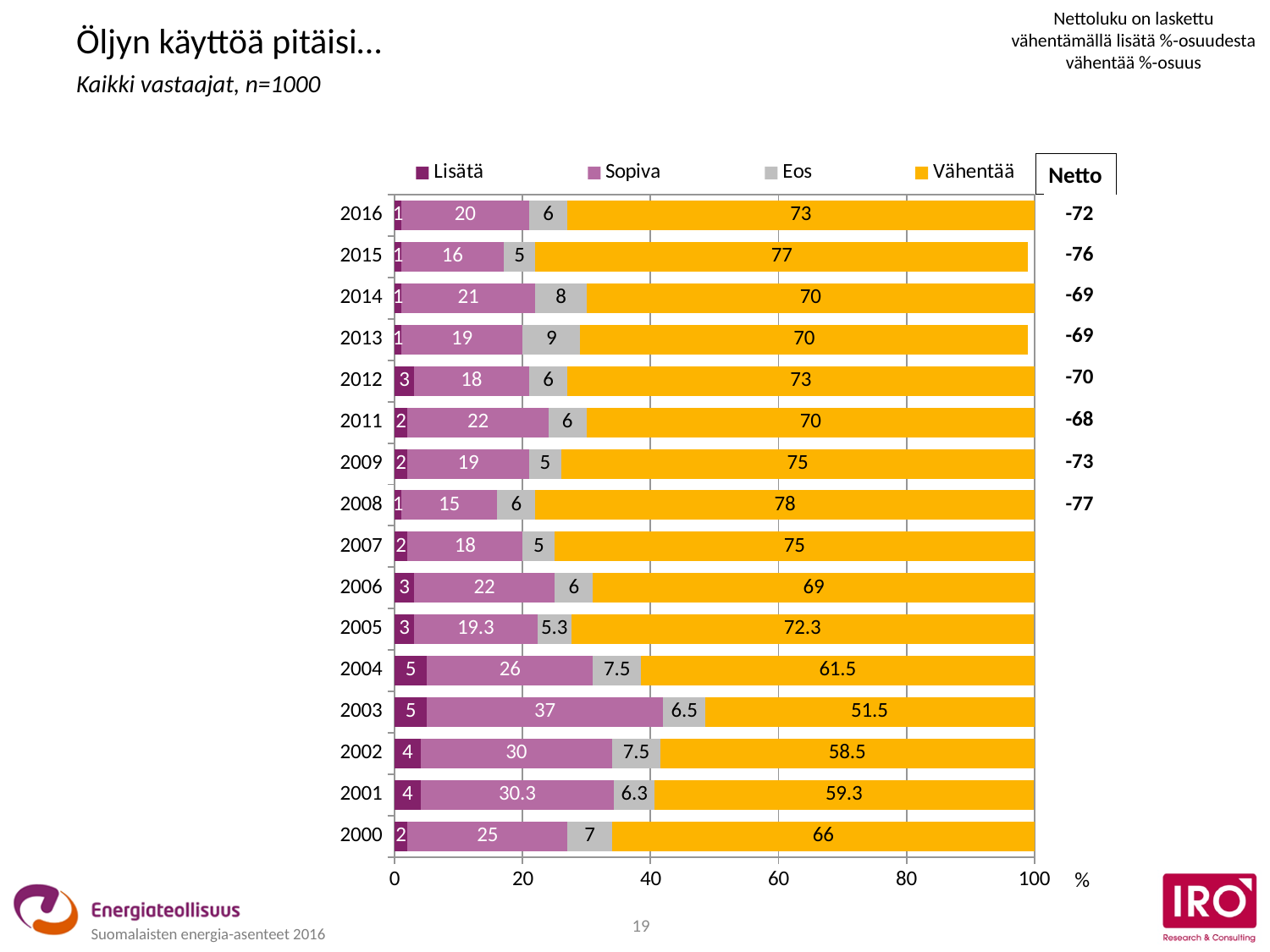
Which year has the highest Vähentää value? 2008 How many series does the legend list? 4 Is the Sopiva value larger for 2004 or for 2006? 2004 What is the Eos value for 2004? 7.5 What is the Vähentää value for 2015? 77 What kind of chart is shown on the slide? Stacked bar chart What is the difference between the Vähentää values for 2008 and 2003? 26.5 What is the Sopiva value for 2003? 37 Which year has the lowest Vähentää value? 2003 What is the Lisätä value for 2012? 3 What is the Netto value shown for 2016? -72 How many years are shown on the chart? 16